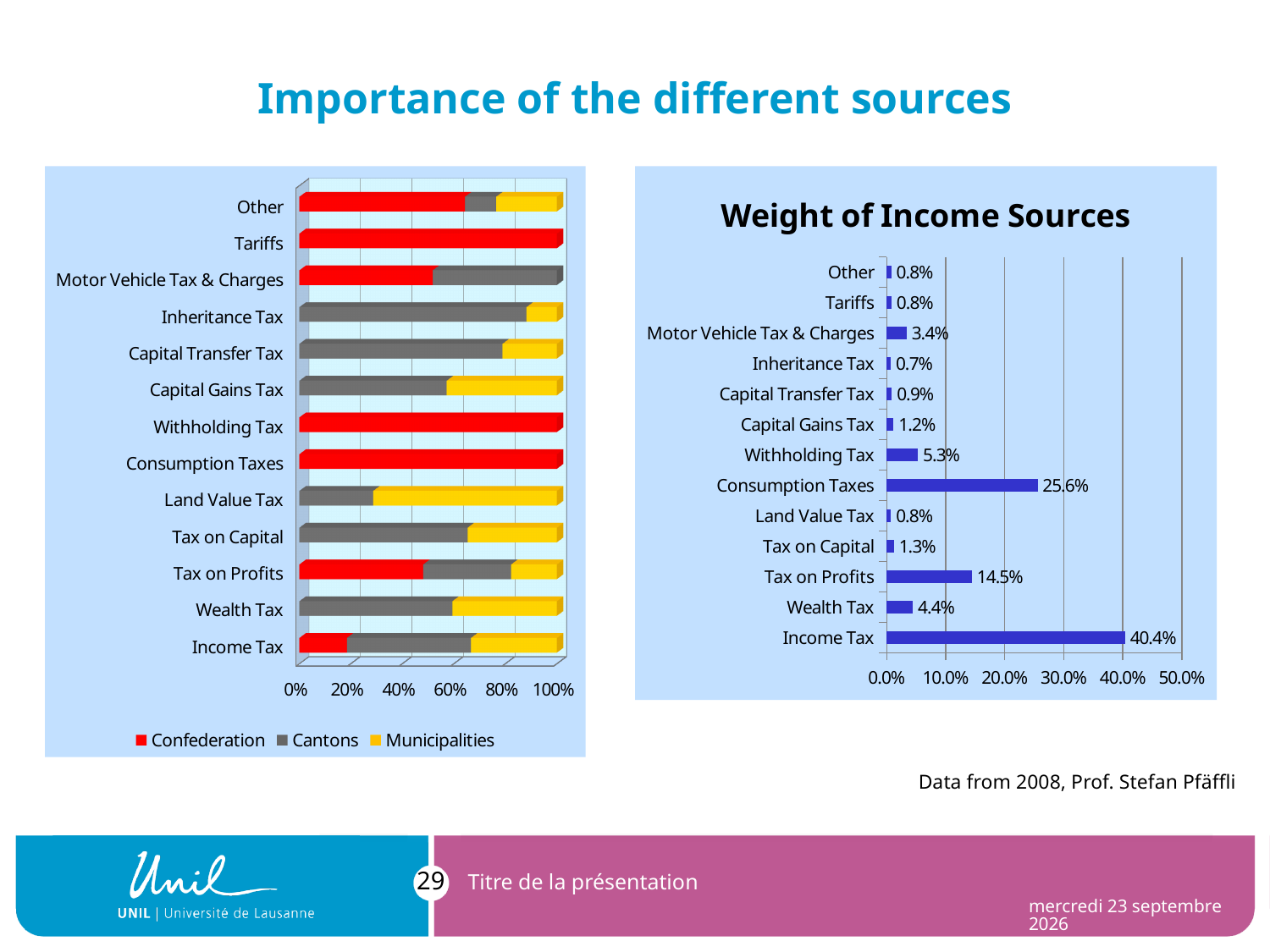
On the chart titled 'Weight of Income Sources', what is the value for Consumption Taxes? 25.6% How many series does the legend of the left-hand stacked chart list? 3 On the chart titled 'Weight of Income Sources', which category has the lowest value? Inheritance Tax On the chart titled 'Weight of Income Sources', which is larger: Tax on Profits or Withholding Tax? Tax on Profits How many categories are shown on the chart titled 'Weight of Income Sources'? 13 On the chart titled 'Weight of Income Sources', what is the value for Withholding Tax? 5.3% What kind of chart is the chart titled 'Weight of Income Sources'? bar chart On the chart titled 'Weight of Income Sources', is the value for Consumption Taxes greater or less than 20.0%? greater On the left-hand stacked chart, is the Confederation share for Tariffs greater or less than 80%? greater On the chart titled 'Weight of Income Sources', what is the difference between Income Tax and Consumption Taxes? 14.8% On the chart titled 'Weight of Income Sources', what is the value for Income Tax? 40.4% On the chart titled 'Weight of Income Sources', which category has the highest value? Income Tax